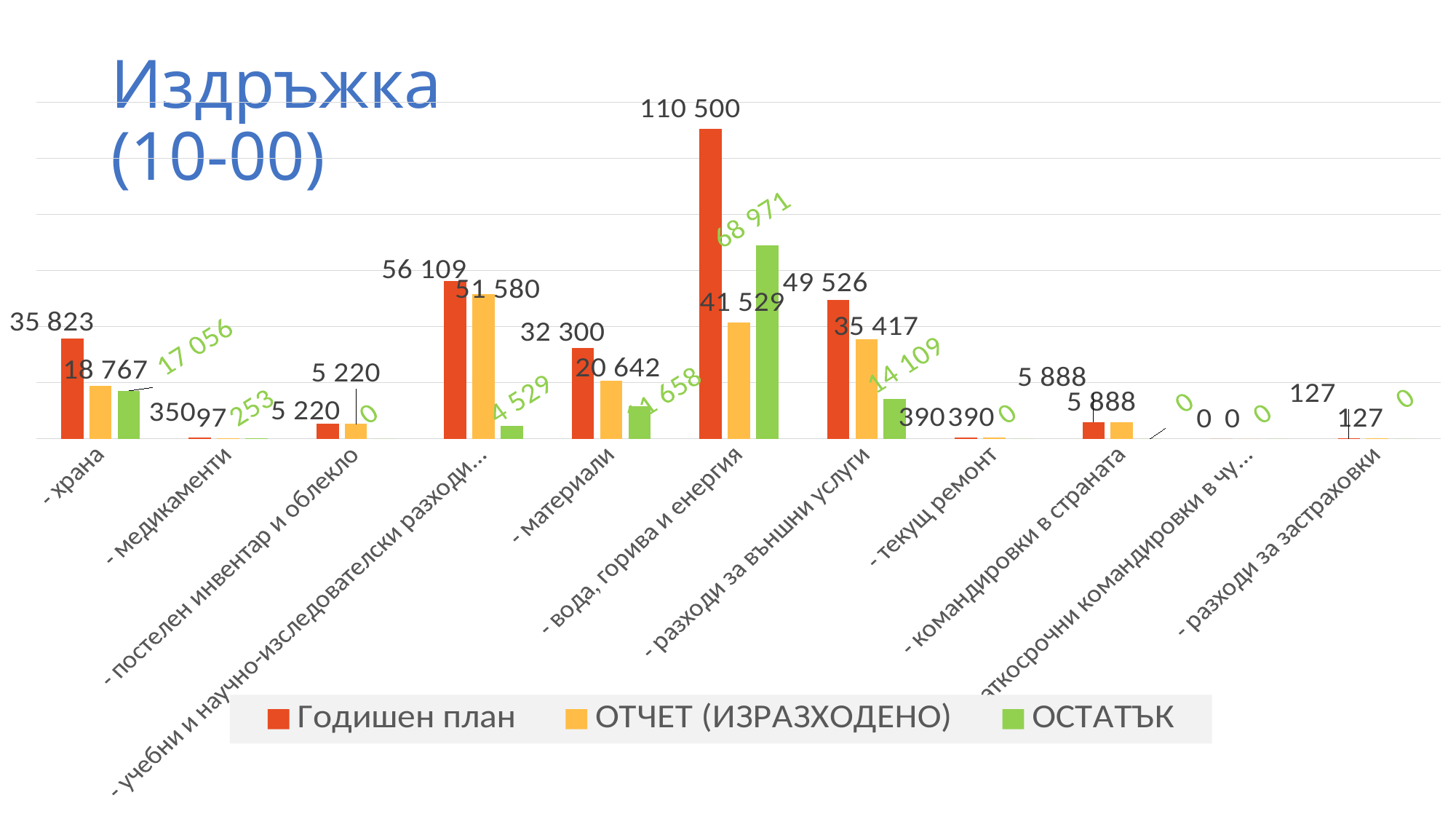
Which category has the highest Годишен план value? - вода, горива и енергия What is the ОСТАТЪК value for - разходи за външни услуги? 14 109 What is the ОТЧЕТ (ИЗРАЗХОДЕНО) value for - вода, горива и енергия? 41 529 What is the ОСТАТЪК value for - медикаменти? 253 What is the difference between the Годишен план and ОТЧЕТ (ИЗРАЗХОДЕНО) values for - храна? 17 056 What kind of chart is shown on the slide? bar chart Which has the larger ОТЧЕТ (ИЗРАЗХОДЕНО) value, - материали or - храна? - материали What is the title of the slide? Издръжка (10-00) What is the Годишен план value for - храна? 35 823 How many series does the legend list? 3 How many categories are shown on the x axis? 11 What is the Годишен план value for - командировки в страната? 5 888